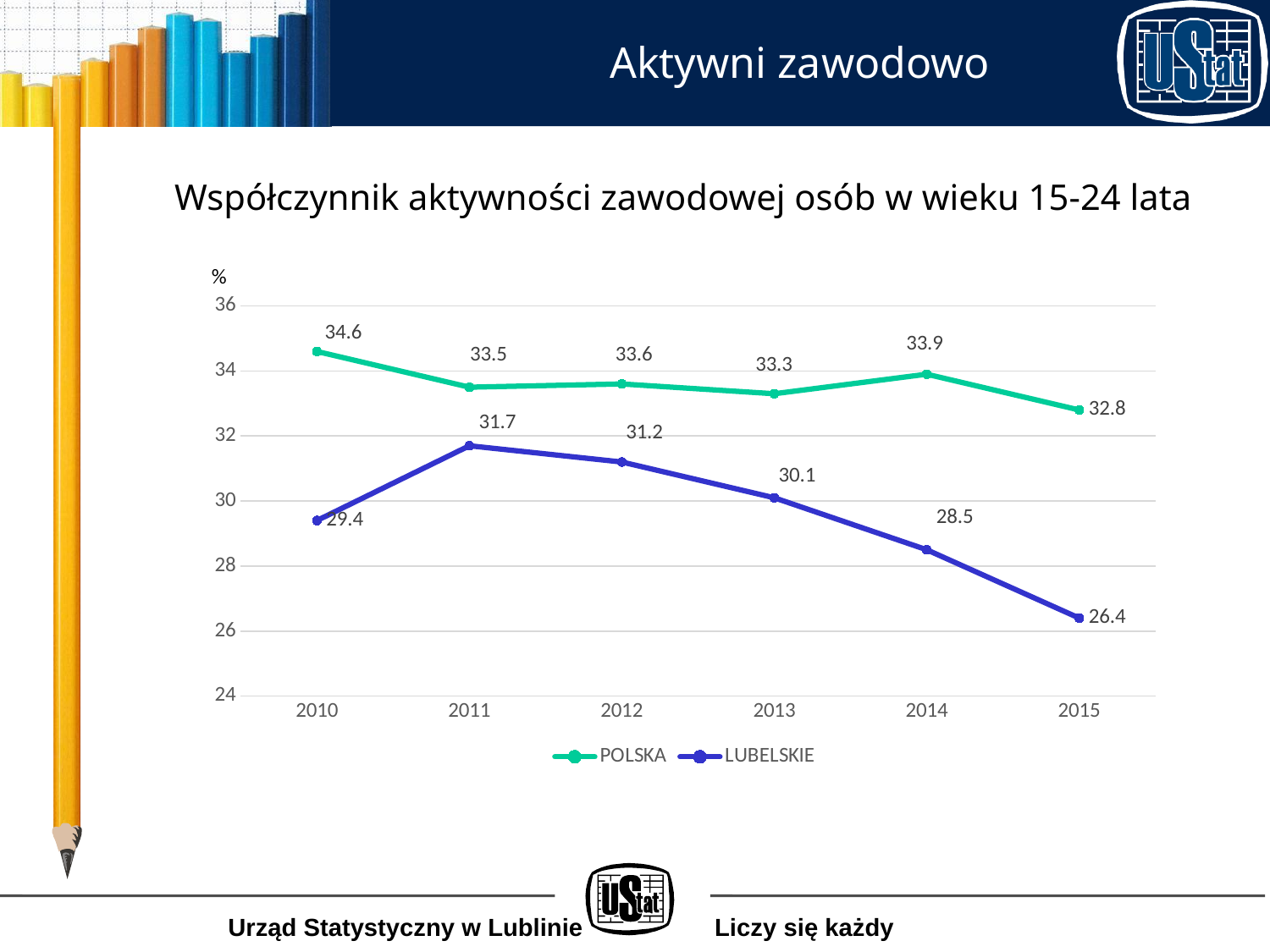
Which series has the larger value in 2014, POLSKA or LUBELSKIE? POLSKA How many series does the legend list? 2 How many years are shown on the x axis? 6 What is the value for LUBELSKIE in 2013? 30.1 Does the LUBELSKIE series rise or fall from 2011 to 2015? fall What is the value for LUBELSKIE in 2015? 26.4 What is the difference between the POLSKA and LUBELSKIE values in 2015? 6.4 In which year is the LUBELSKIE value highest? 2011 What is the value for POLSKA in 2010? 34.6 Is the value for LUBELSKIE in 2014 greater or less than 30? less In which year is the POLSKA value lowest? 2015 What kind of chart is shown on the slide? line chart